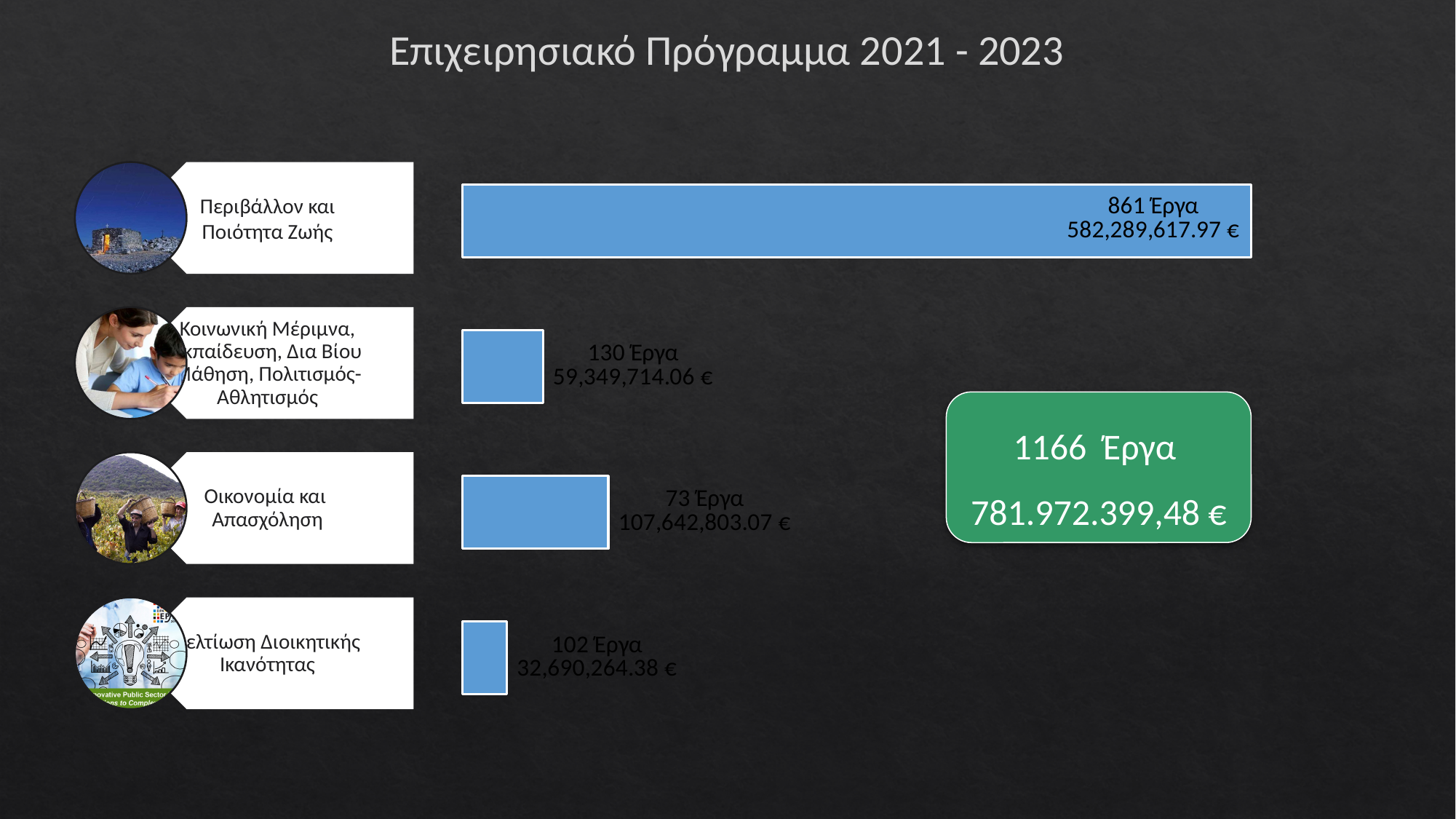
What is the amount in euros shown for Οικονομία και Απασχόληση? 107,642,803.07 € Which category has the fewest projects (Έργα)? Οικονομία και Απασχόληση What is the difference in number of projects between Περιβάλλον και Ποιότητα Ζωής and the Κοινωνική Μέριμνα category? 731 What total number of projects is shown in the green box? 1166 Έργα How many categories (bars) are shown in the chart? 4 How many projects (Έργα) are shown for Περιβάλλον και Ποιότητα Ζωής? 861 Έργα Which category has the highest amount in euros? Περιβάλλον και Ποιότητα Ζωής What is the amount in euros shown for the Κοινωνική Μέριμνα category? 59,349,714.06 € Which has more projects: Οικονομία και Απασχόληση or the Διοικητικής Ικανότητας category? Βελτίωση Διοικητικής Ικανότητας What kind of chart is shown on the slide? Bar chart How many projects (Έργα) are shown for the Διοικητικής Ικανότητας category? 102 Έργα Which category has the lowest amount in euros? Βελτίωση Διοικητικής Ικανότητας